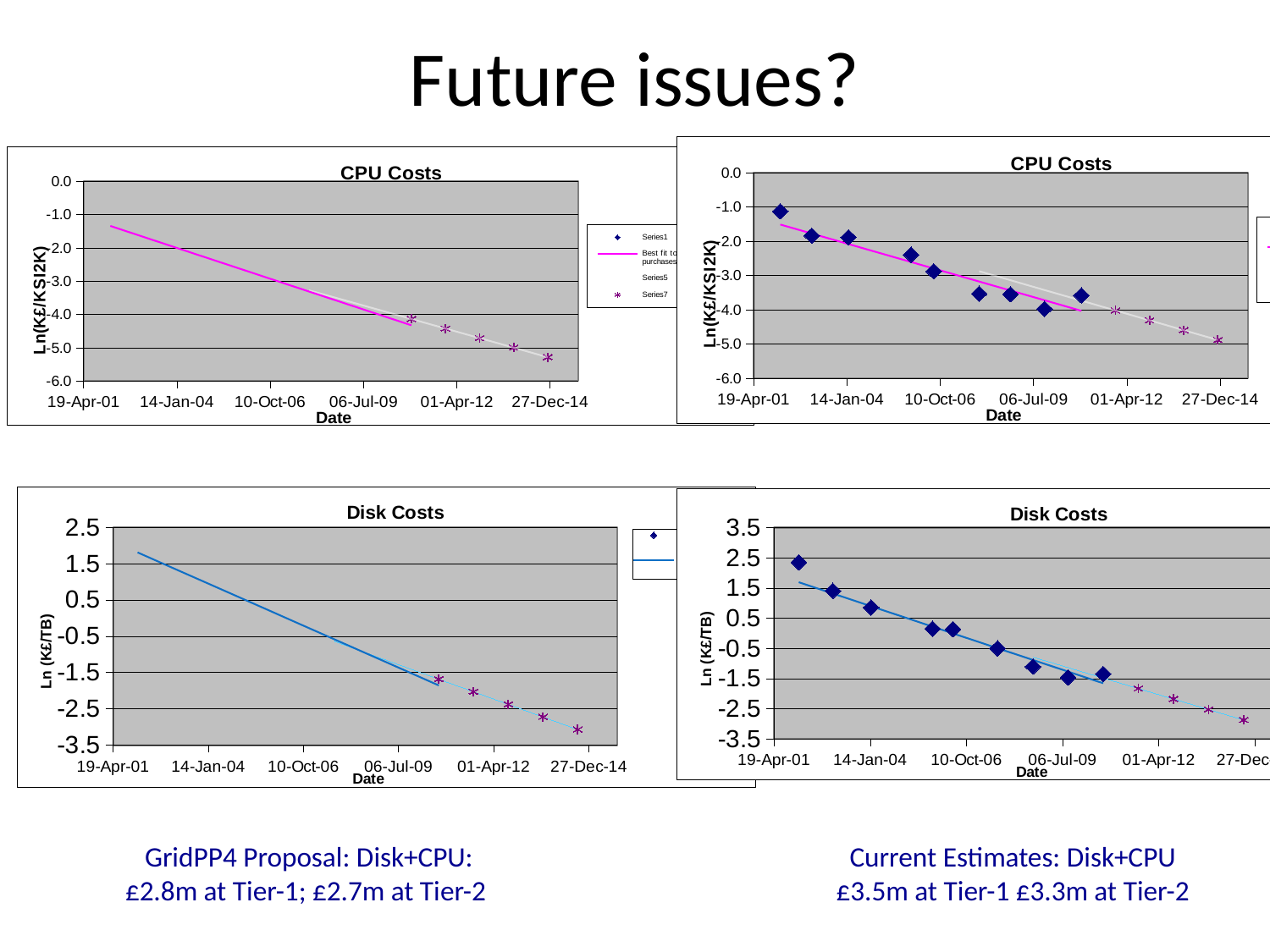
In the top-right CPU Costs chart, do the plotted values rise or fall as the date increases along the x axis? fall How many date labels are shown on the x axis of the top-left CPU Costs chart? 6 What is the x-axis title of the top-right CPU Costs chart? Date In the bottom-left Disk Costs chart, is the value of the last star point (near 27-Dec-14) greater or less than -2.5? less In the bottom-right Disk Costs chart, is the value of the first diamond point (near 19-Apr-01) greater or less than 1.5? greater In the bottom-right Disk Costs chart, do the plotted values rise or fall from left to right along the x axis? fall In the top-right CPU Costs chart, is the value of the last star point (near 27-Dec-14) greater or less than -4.0? less In the top-right CPU Costs chart, which is higher: the first diamond point near 19-Apr-01 or the last star point near 27-Dec-14? the first diamond point near 19-Apr-01 What kind of chart is the top-left CPU Costs chart? scatter chart What is the y-axis title of the bottom-left Disk Costs chart? Ln (K£/TB)